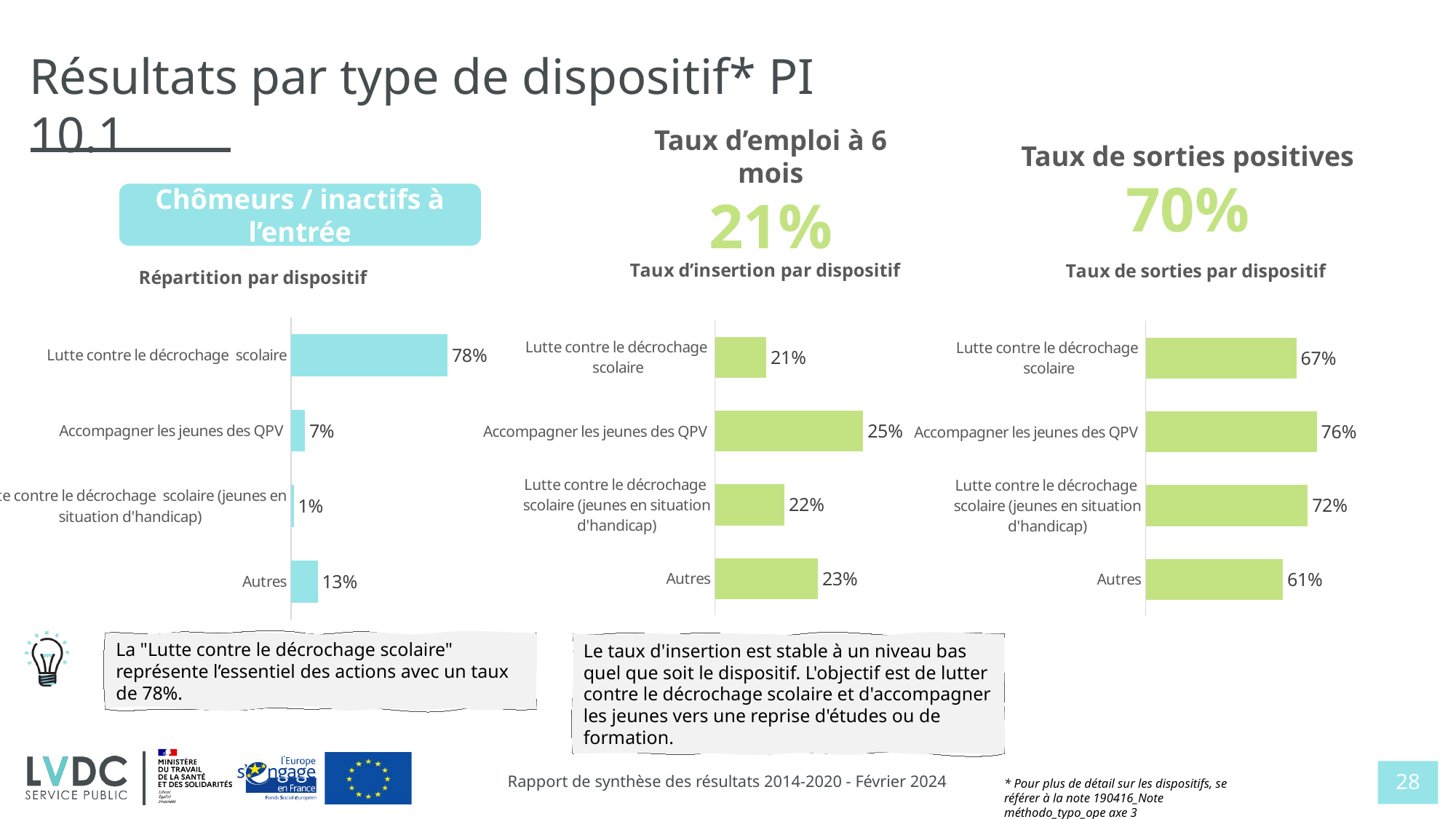
In the 'Taux d'insertion par dispositif' chart, which category has the highest value? Accompagner les jeunes des QPV What kind of chart is the 'Taux d'insertion par dispositif' chart? Bar chart In the 'Répartition par dispositif' chart, which category has the lowest value? Lutte contre le décrochage scolaire (jeunes en situation d'handicap) In the 'Taux d'insertion par dispositif' chart, what is the value for 'Accompagner les jeunes des QPV'? 25% How many categories does the 'Répartition par dispositif' chart show? 4 In the 'Taux d'insertion par dispositif' chart, what is the value for 'Autres'? 23% In the 'Répartition par dispositif' chart, what is the difference between 'Autres' and 'Accompagner les jeunes des QPV'? 6% In the 'Répartition par dispositif' chart, what is the value for 'Lutte contre le décrochage scolaire'? 78% In the 'Taux de sorties par dispositif' chart, what is the value for 'Lutte contre le décrochage scolaire (jeunes en situation d'handicap)'? 72% In the 'Taux de sorties par dispositif' chart, what is the difference between 'Accompagner les jeunes des QPV' and 'Lutte contre le décrochage scolaire'? 9% In the 'Taux de sorties par dispositif' chart, which category has the lowest value? Autres In the 'Taux de sorties par dispositif' chart, which is larger: 'Lutte contre le décrochage scolaire' or 'Autres'? Lutte contre le décrochage scolaire